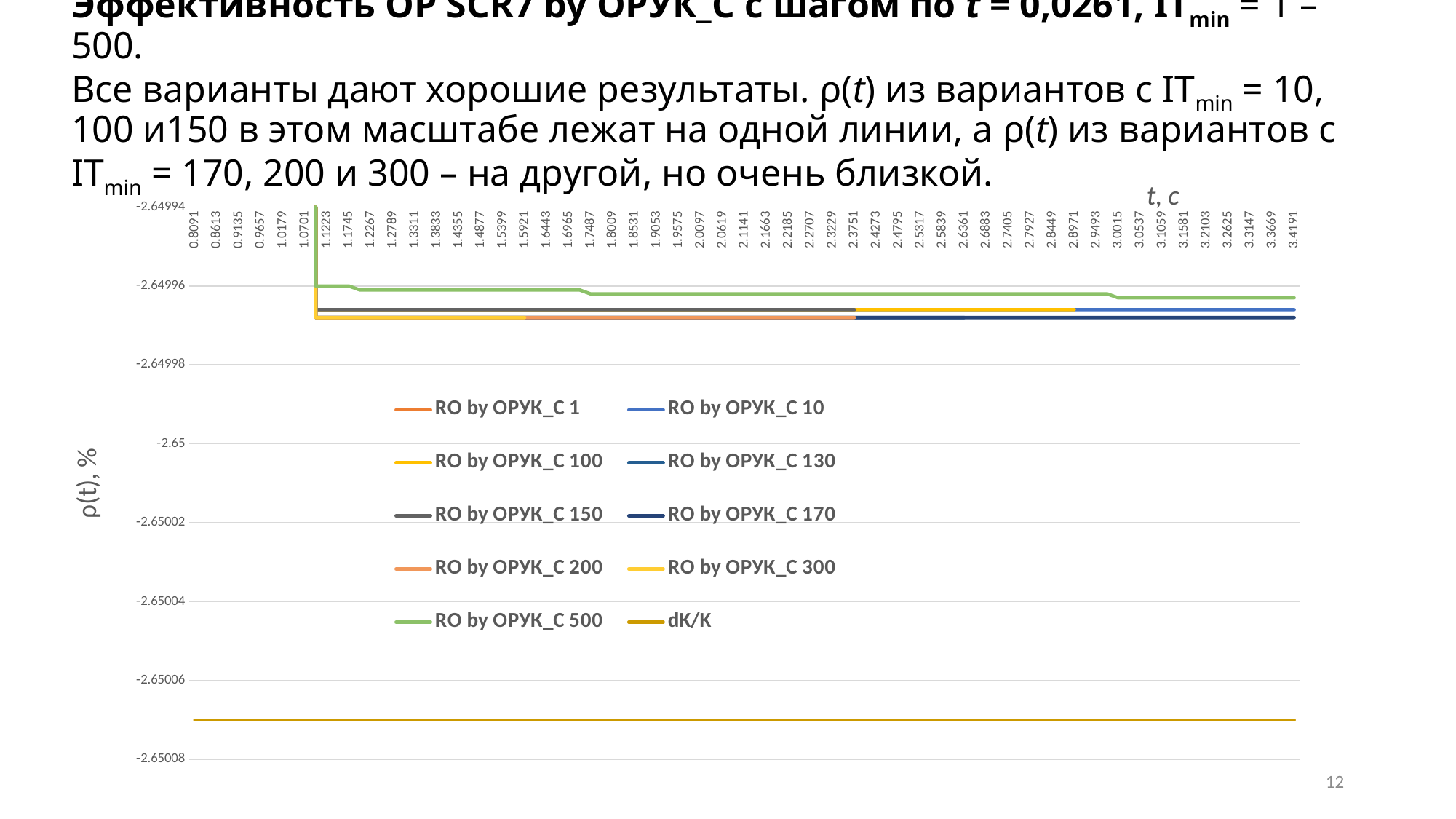
Is the value of the RO by ОРУК_С 150 line greater or less than -2.65? greater Which of the RO by ОРУК_С series lies highest on the chart? RO by ОРУК_С 500 How many series does the chart legend list? 10 Is the value of the RO by ОРУК_С 500 line greater or less than -2.64998? greater What is the label of the horizontal axis of the chart? t, c Which is larger, the value of dK/K or the value of RO by ОРУК_С 500? RO by ОРУК_С 500 Does the RO by ОРУК_С 500 line rise or fall along the x axis? fall Which series lies lowest on the chart? dK/K Is the value of the dK/K line greater or less than -2.65006? less What kind of chart is shown on the slide? line chart What is the label of the vertical axis of the chart? ρ(t), %